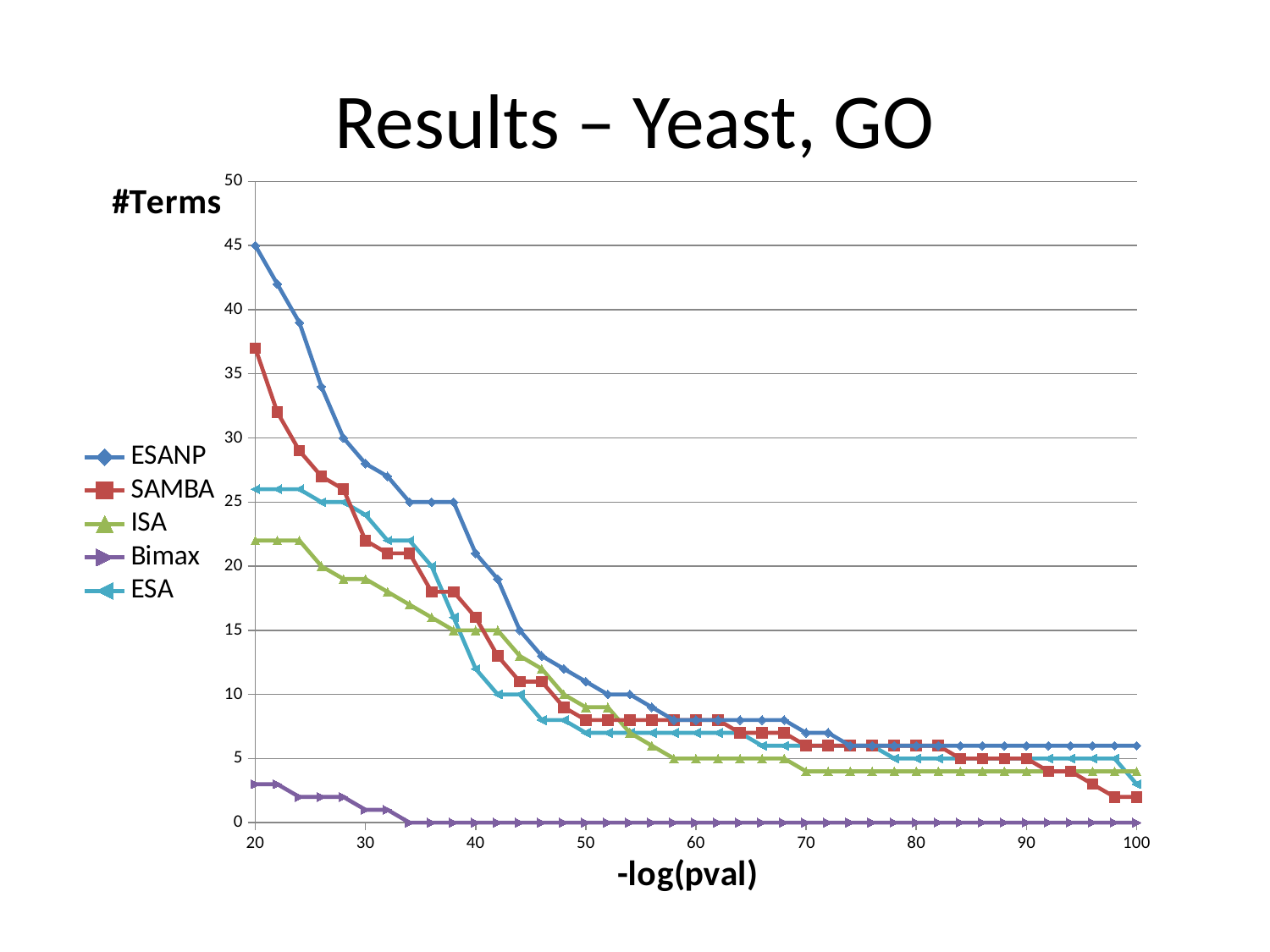
What is the value of ESANP at -log(pval) = 20? 45 Which series has the lowest number of terms at -log(pval) = 20? Bimax What kind of chart is shown on the slide? line chart Which series has the highest number of terms at -log(pval) = 20? ESANP How many series does the legend list? 5 Is the value for SAMBA at -log(pval) = 100 greater or less than 5? less Is the value for SAMBA at -log(pval) = 20 greater or less than 35? greater What is the value of Bimax at -log(pval) = 100? 0 At -log(pval) = 20, which is larger, ESANP or SAMBA? ESANP Do the values for ESANP rise or fall as -log(pval) increases? fall What is the label of the x axis? -log(pval)